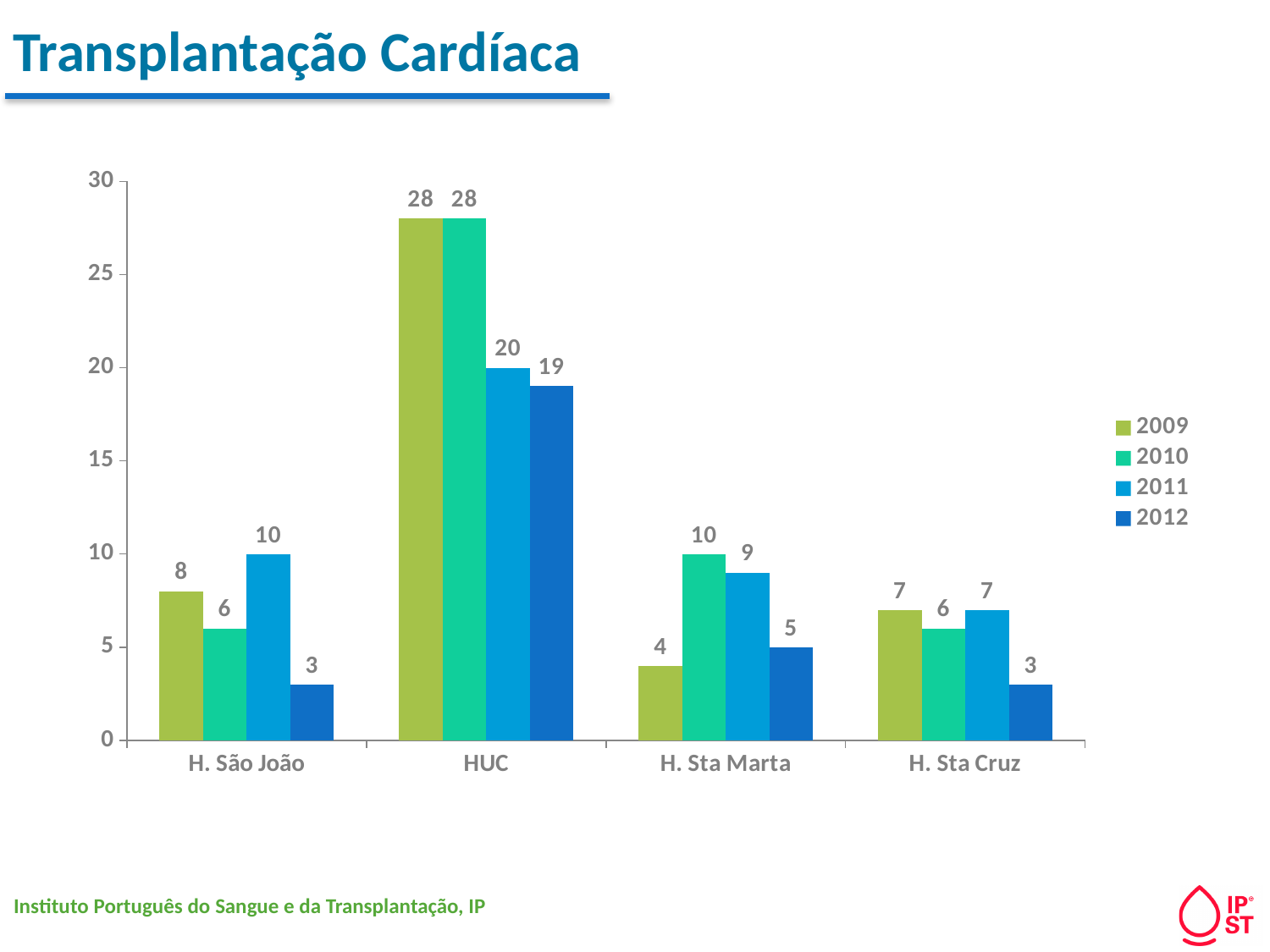
What kind of chart is shown? Bar chart How many series does the legend list? 4 Which hospital has the lowest value in 2010? H. São João and H. Sta Cruz (tied at 6) Do the values for HUC rise or fall from 2010 to 2012? Fall What is the title of the slide? Transplantação Cardíaca What is the value for HUC in 2011? 20 What is the difference between the 2010 and 2012 values for HUC? 9 What is the value for H. Sta Marta in 2010? 10 How many hospitals are shown on the x axis? 4 Which is larger: the 2011 value for H. São João or the 2011 value for H. Sta Cruz? H. São João What is the value for H. São João in 2012? 3 Which hospital has the highest value in 2009? HUC